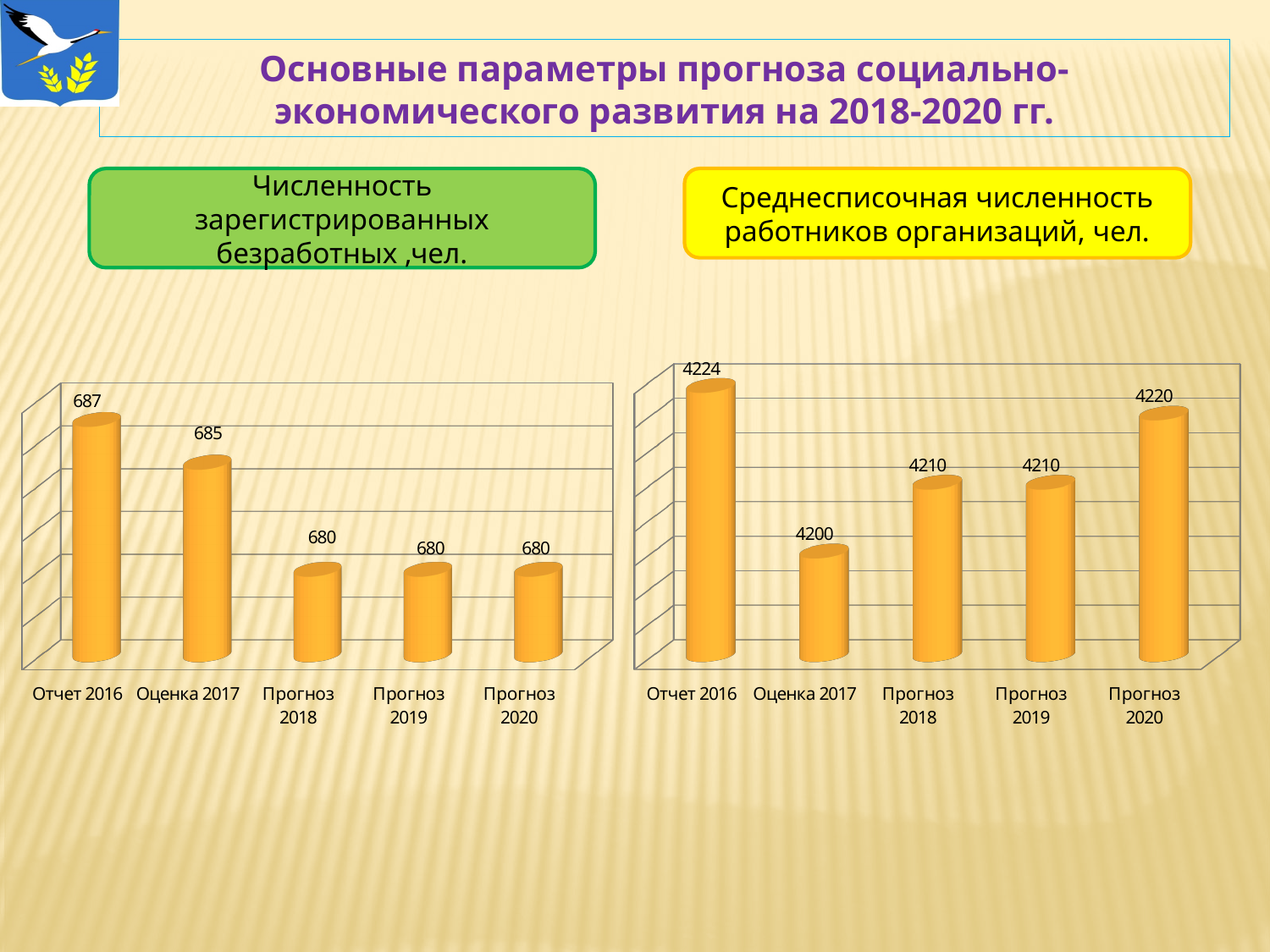
In the left chart (Численность зарегистрированных безработных), what is the value for Отчет 2016? 687 What type of chart is the right chart (Среднесписочная численность работников организаций)? bar chart In the left chart (Численность зарегистрированных безработных), what is the difference between Отчет 2016 and Прогноз 2020? 7 In the right chart (Среднесписочная численность работников организаций), what is the value for Прогноз 2019? 4210 In the right chart (Среднесписочная численность работников организаций), what is the value for Отчет 2016? 4224 In the right chart (Среднесписочная численность работников организаций), which category has the lowest value? Оценка 2017 In the left chart (Численность зарегистрированных безработных), do the values rise or fall from Отчет 2016 to Прогноз 2018? fall In the right chart (Среднесписочная численность работников организаций), what is the difference between Отчет 2016 and Оценка 2017? 24 In the right chart (Среднесписочная численность работников организаций), which is larger, Прогноз 2020 or Прогноз 2018? Прогноз 2020 In the left chart (Численность зарегистрированных безработных), how many categories are shown? 5 In the left chart (Численность зарегистрированных безработных), what is the value for Оценка 2017? 685 In the left chart (Численность зарегистрированных безработных), which category has the highest value? Отчет 2016